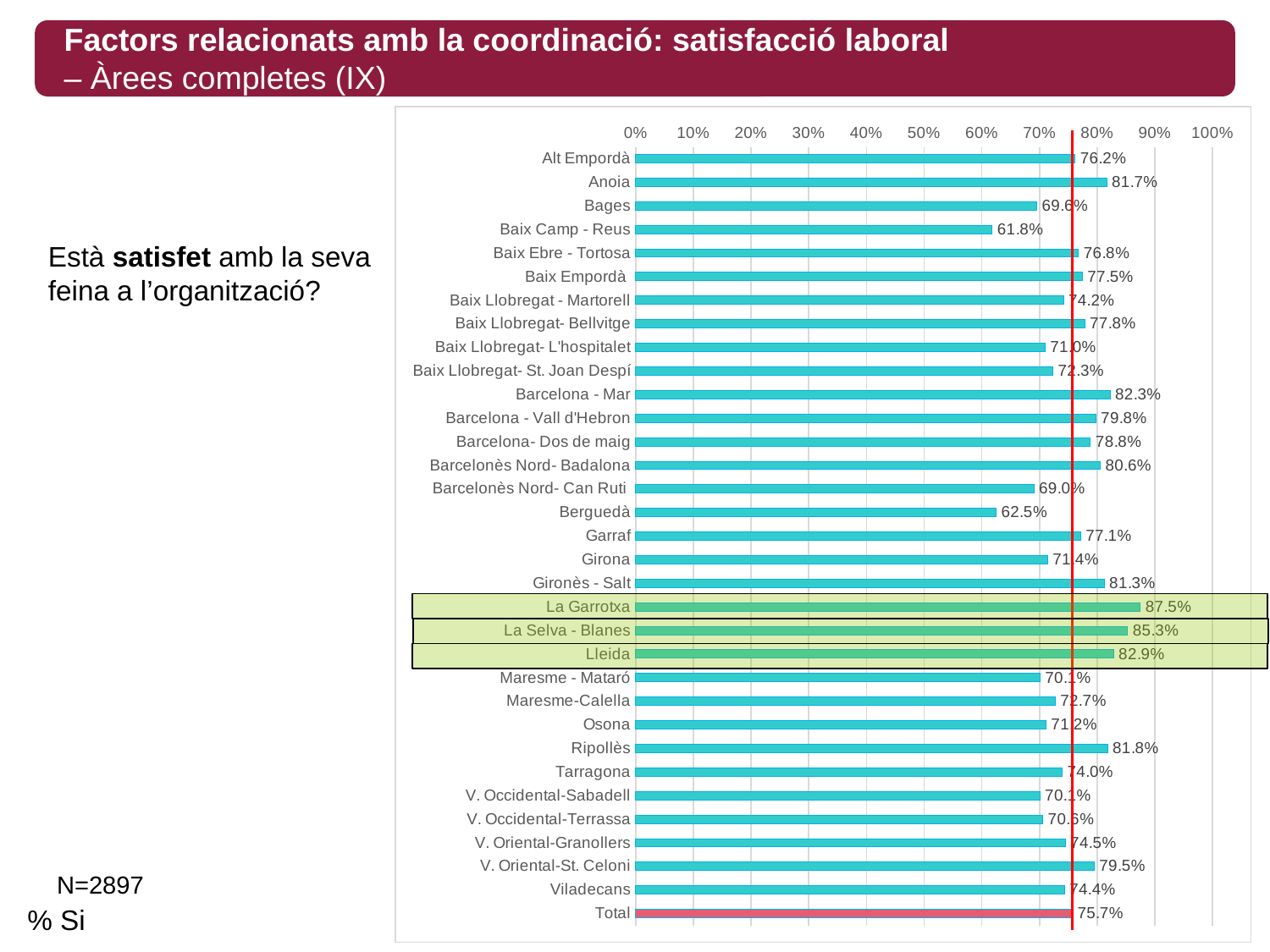
Which category has the highest value? La Garrotxa What is the value for Total? 75.7% What kind of chart is shown on the slide? bar chart Which is larger, the value for Anoia or the value for Ripollès? Ripollès How many bars are plotted in the chart, including Total? 33 Which three categories are highlighted with green bars and boxes? La Garrotxa, La Selva - Blanes, Lleida What is the value for Berguedà? 62.5% What is the value for La Garrotxa? 87.5% Is the value for Baix Camp - Reus greater or less than 70%? less Which category has the lowest value? Baix Camp - Reus What is the difference between the values for La Garrotxa and La Selva - Blanes? 2.2% What is the value for Barcelona - Mar? 82.3%